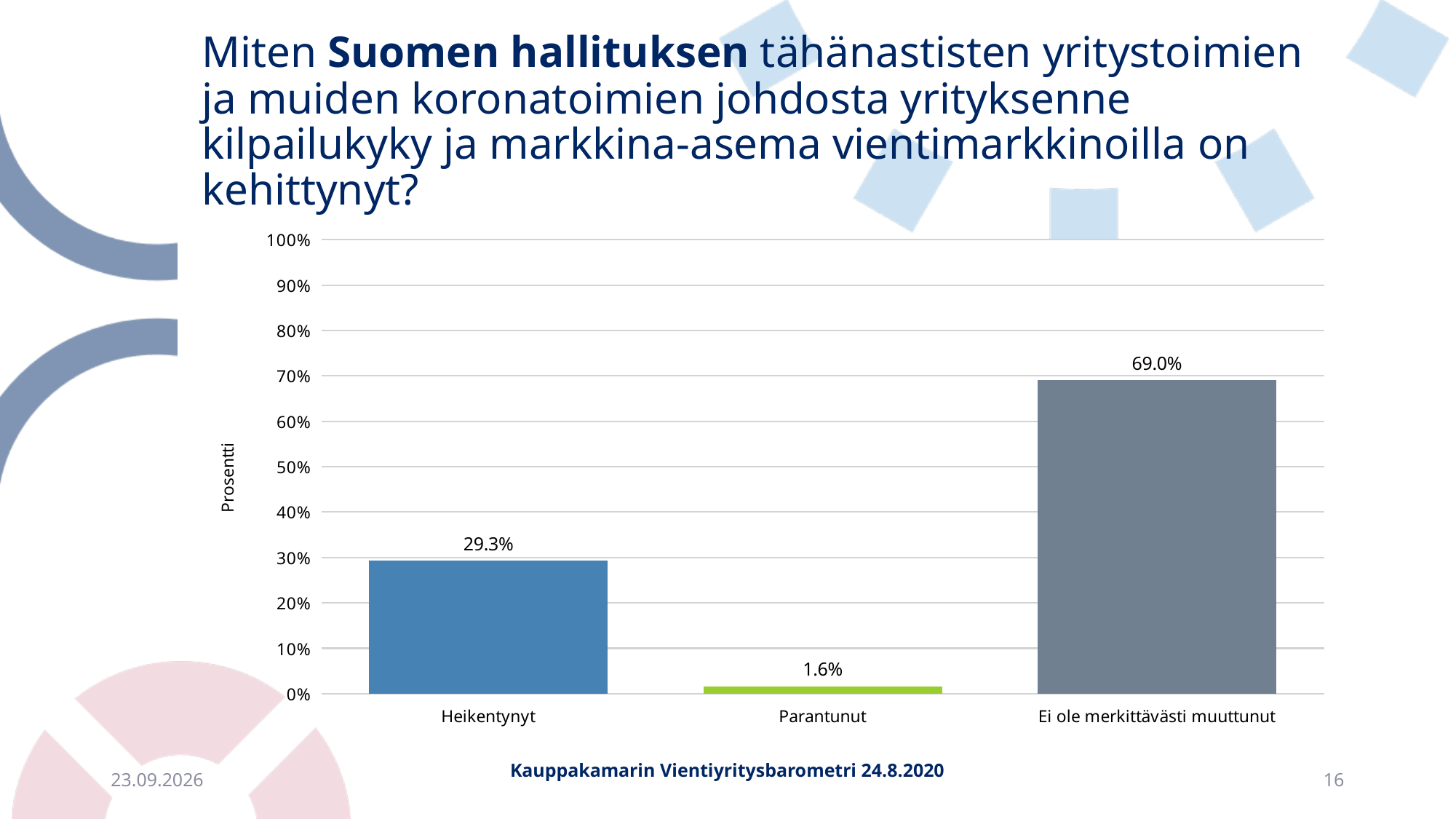
What is the label of the vertical axis? Prosentti What is the difference between the values for Ei ole merkittävästi muuttunut and Heikentynyt? 39.7% What is the value for Ei ole merkittävästi muuttunut? 69.0% What is the difference between the values for Heikentynyt and Parantunut? 27.7% Is the value for Ei ole merkittävästi muuttunut greater or less than 60%? greater How many categories are shown on the x axis? 3 What kind of chart is shown on the slide? bar chart Which category has the highest value? Ei ole merkittävästi muuttunut Which category has the lowest value? Parantunut What is the value for Heikentynyt? 29.3% Which is larger, the value for Heikentynyt or the value for Parantunut? Heikentynyt What is the value for Parantunut? 1.6%